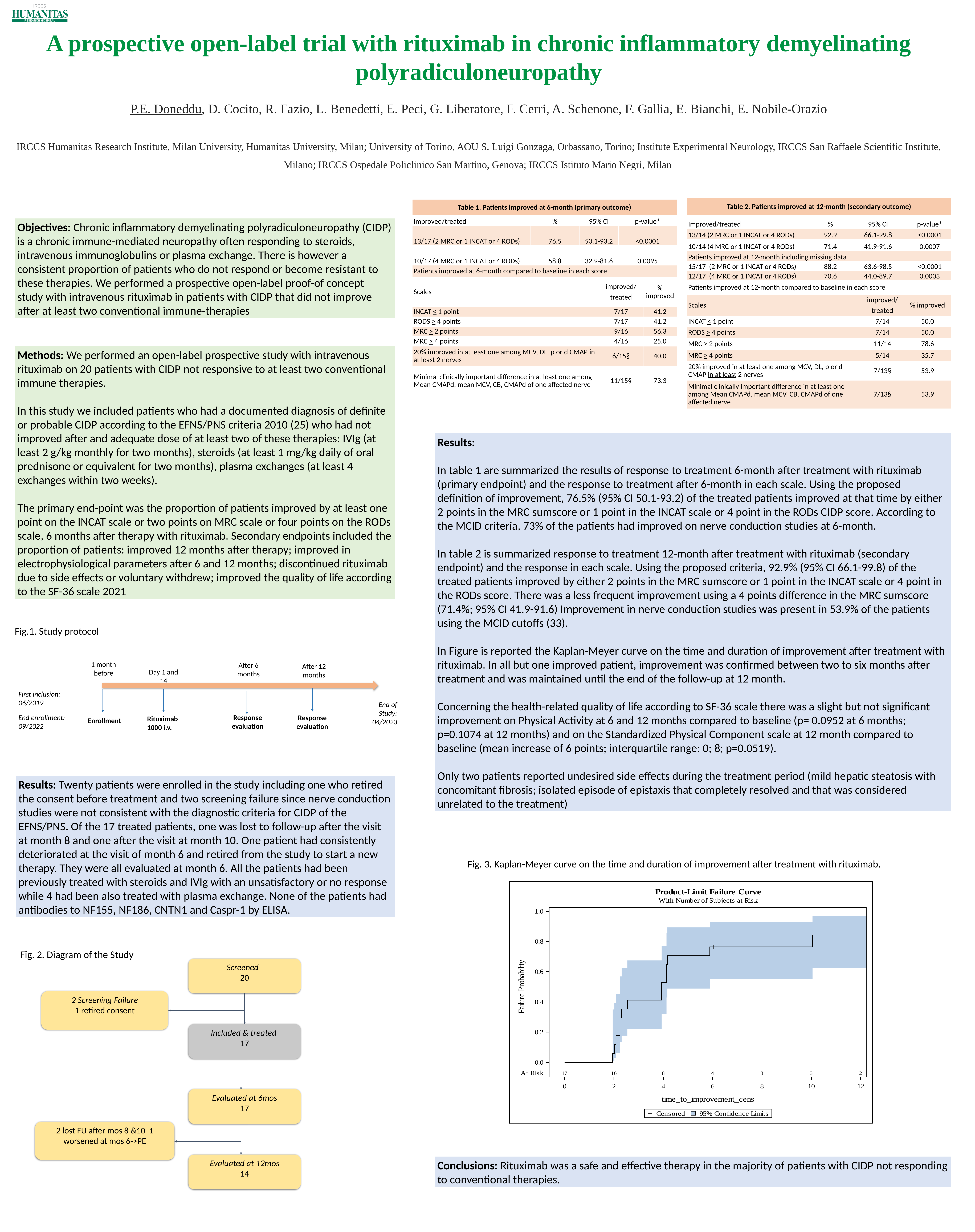
In Fig. 3, is the failure probability at time 6 greater or less than 0.6? greater What is the title printed at the top of the Fig. 3 chart? Product-Limit Failure Curve In Fig. 3, how many time points are listed in the 'At Risk' row? 7 In Fig. 3, is the number at risk at time 6 larger or smaller than at time 2? smaller In Fig. 3, at which time point is the number of subjects at risk highest? 0 In Fig. 3, how many subjects are at risk at time 12? 2 In Fig. 3, how many subjects are at risk at time 4? 8 In Fig. 3, what is the difference between the number at risk at time 2 and at time 4? 8 What kind of chart is shown in Fig. 3? line chart In the Fig. 3 Kaplan-Meier curve, does the failure probability rise or fall as time increases along the x axis? rise How many entries does the legend of the Fig. 3 chart list? 2 In Fig. 3, how many subjects are at risk at time 0? 17